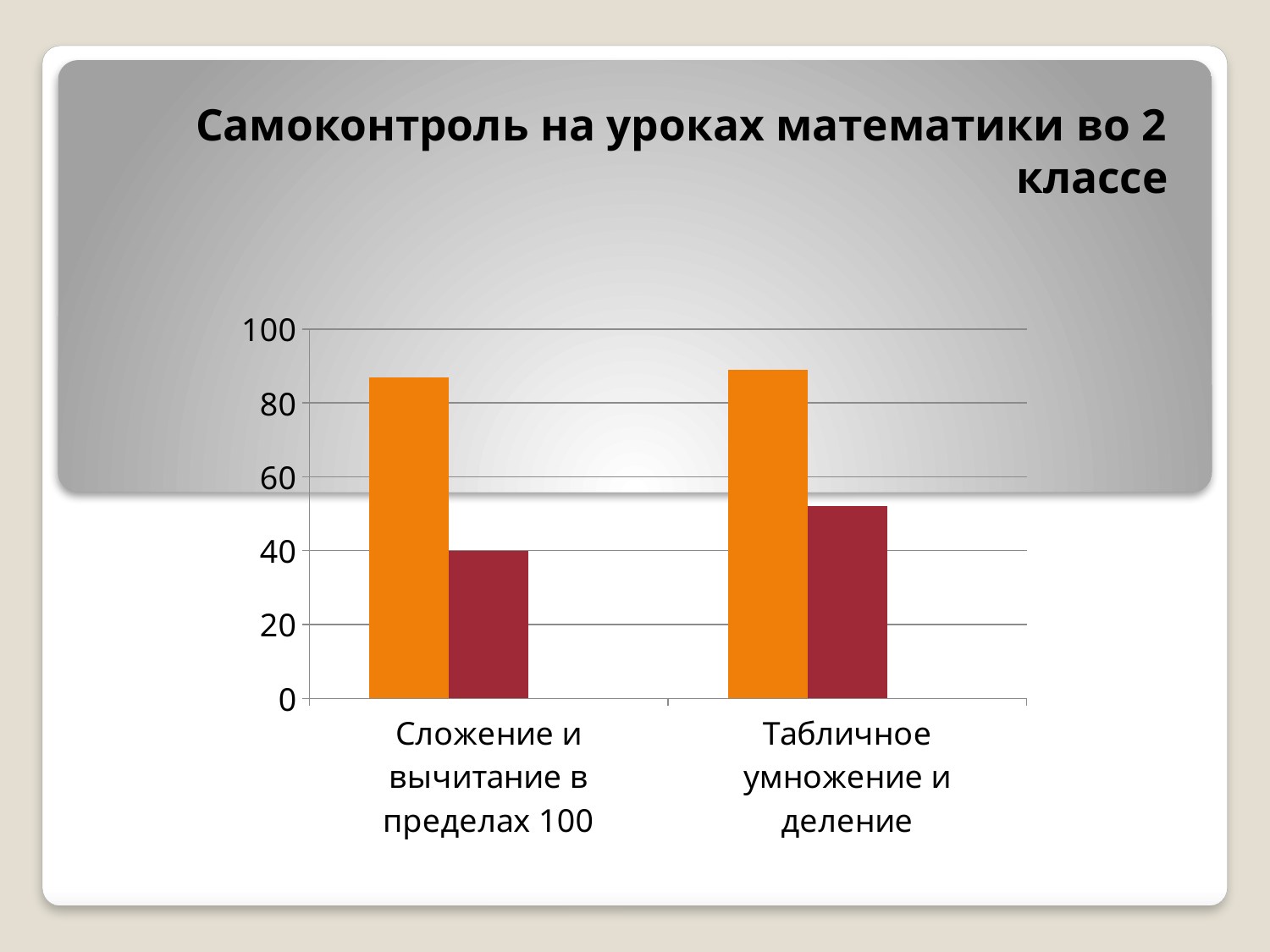
Is the orange bar for 'Табличное умножение и деление' greater or less than 80? greater Is the dark red bar for 'Табличное умножение и деление' greater or less than 60? less What is the title of the slide with the chart? Самоконтроль на уроках математики во 2 классе What is the highest value shown on the vertical axis of the chart? 100 Which is larger for 'Сложение и вычитание в пределах 100': the orange bar or the dark red bar? the orange bar Is the dark red bar for 'Сложение и вычитание в пределах 100' greater or less than 60? less Which category has the higher dark red bar? Табличное умножение и деление How many categories are shown on the x axis of the chart? 2 How many bars are plotted for each category in the chart? 2 What kind of chart is shown on the slide? bar chart Which category has the lower dark red bar? Сложение и вычитание в пределах 100